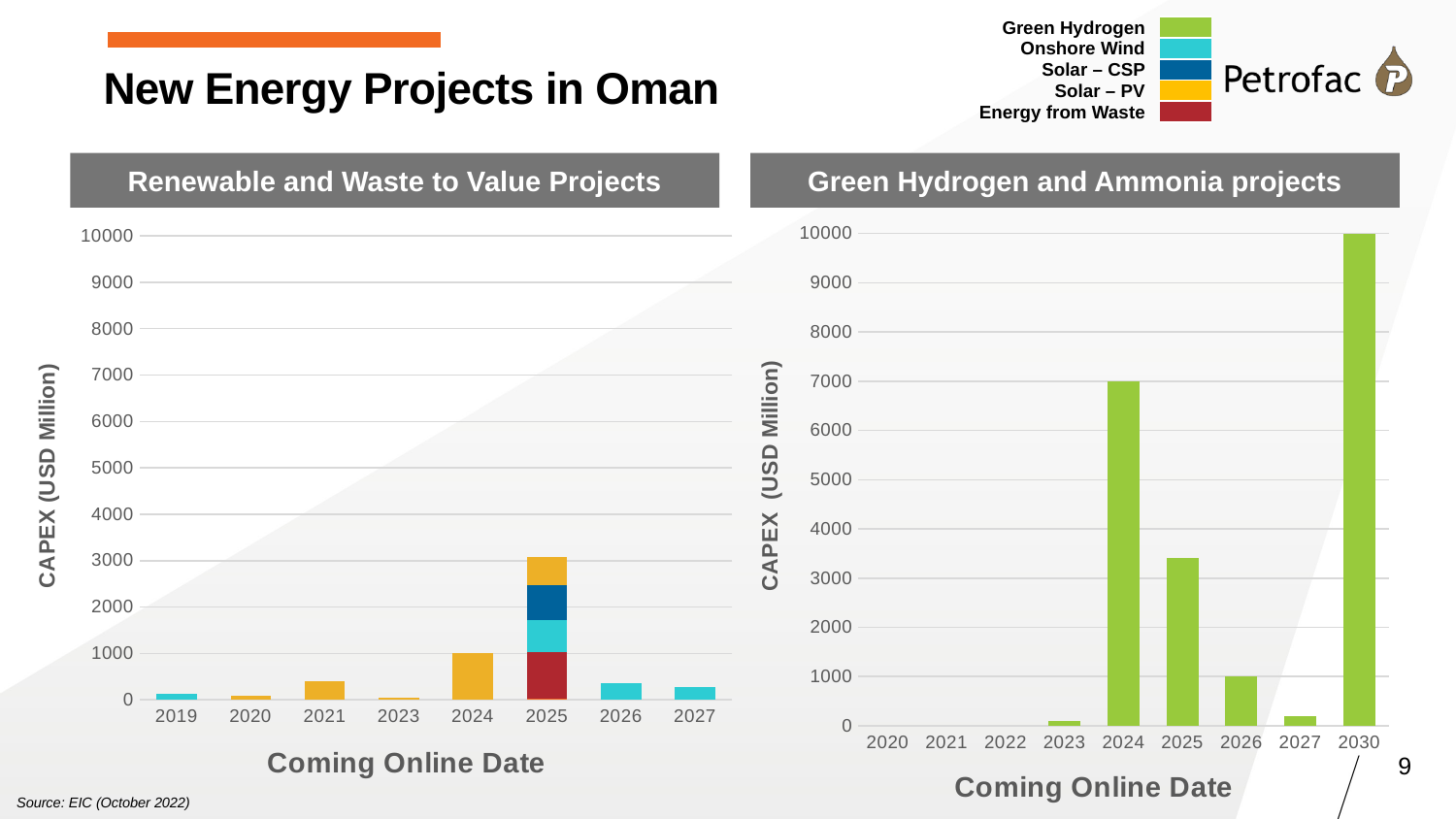
How many years are shown on the x axis of the 'Renewable and Waste to Value Projects' chart? 8 In the 'Green Hydrogen and Ammonia projects' chart, what is the CAPEX (USD Million) for 2030? 10000 In the 'Renewable and Waste to Value Projects' chart, which year has the highest total CAPEX? 2025 How many years are shown on the x axis of the 'Green Hydrogen and Ammonia projects' chart? 9 In the 'Renewable and Waste to Value Projects' chart, is the value for 2024 greater or less than 2000? less In the 'Green Hydrogen and Ammonia projects' chart, is the value for 2025 greater or less than 3000? greater What kind of chart is the 'Green Hydrogen and Ammonia projects' chart? bar chart In the 'Green Hydrogen and Ammonia projects' chart, what is the CAPEX (USD Million) for 2024? 7000 How many series does the legend at the top of the slide list? 5 In the 'Green Hydrogen and Ammonia projects' chart, which is larger, the value for 2024 or the value for 2025? 2024 In the 'Green Hydrogen and Ammonia projects' chart, which year has the highest CAPEX? 2030